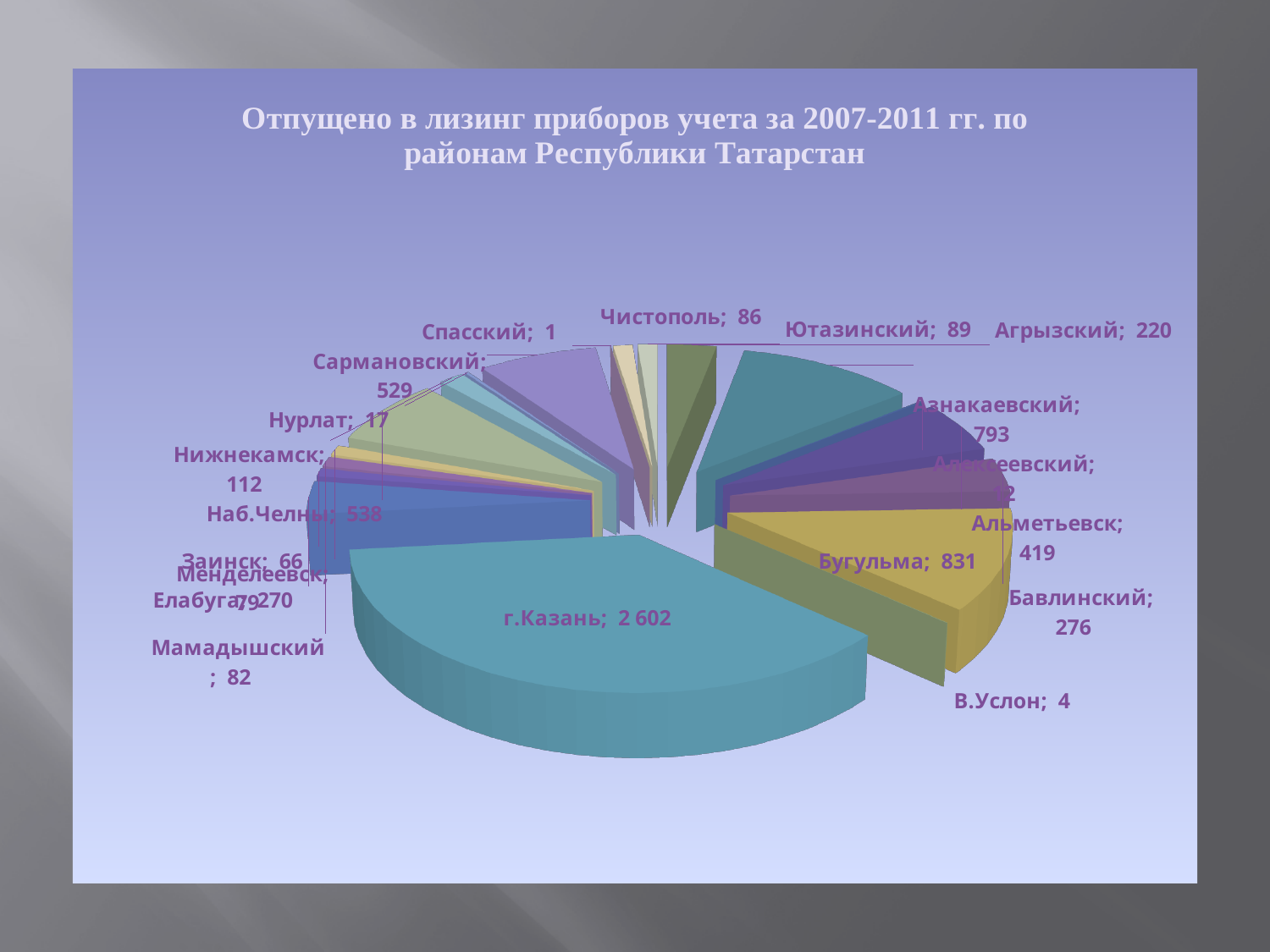
What is the value shown for В.Услон? 4 Which district has the smallest value in the pie chart? Спасский Which is larger, the value for Альметьевск or the value for Бавлинский? Альметьевск What is the value shown for Наб.Челны? 538 What is the title of the chart? Отпущено в лизинг приборов учета за 2007-2011 гг. по районам Республики Татарстан What is the value shown for Азнакаевский? 793 Which district has the largest slice of the pie? г.Казань What is the value shown for Сармановский? 529 What is the value shown for Бугульма? 831 What is the difference between the values for Бугульма and Азнакаевский? 38 What kind of chart is shown on the slide? pie chart What is the value shown for г.Казань? 2 602